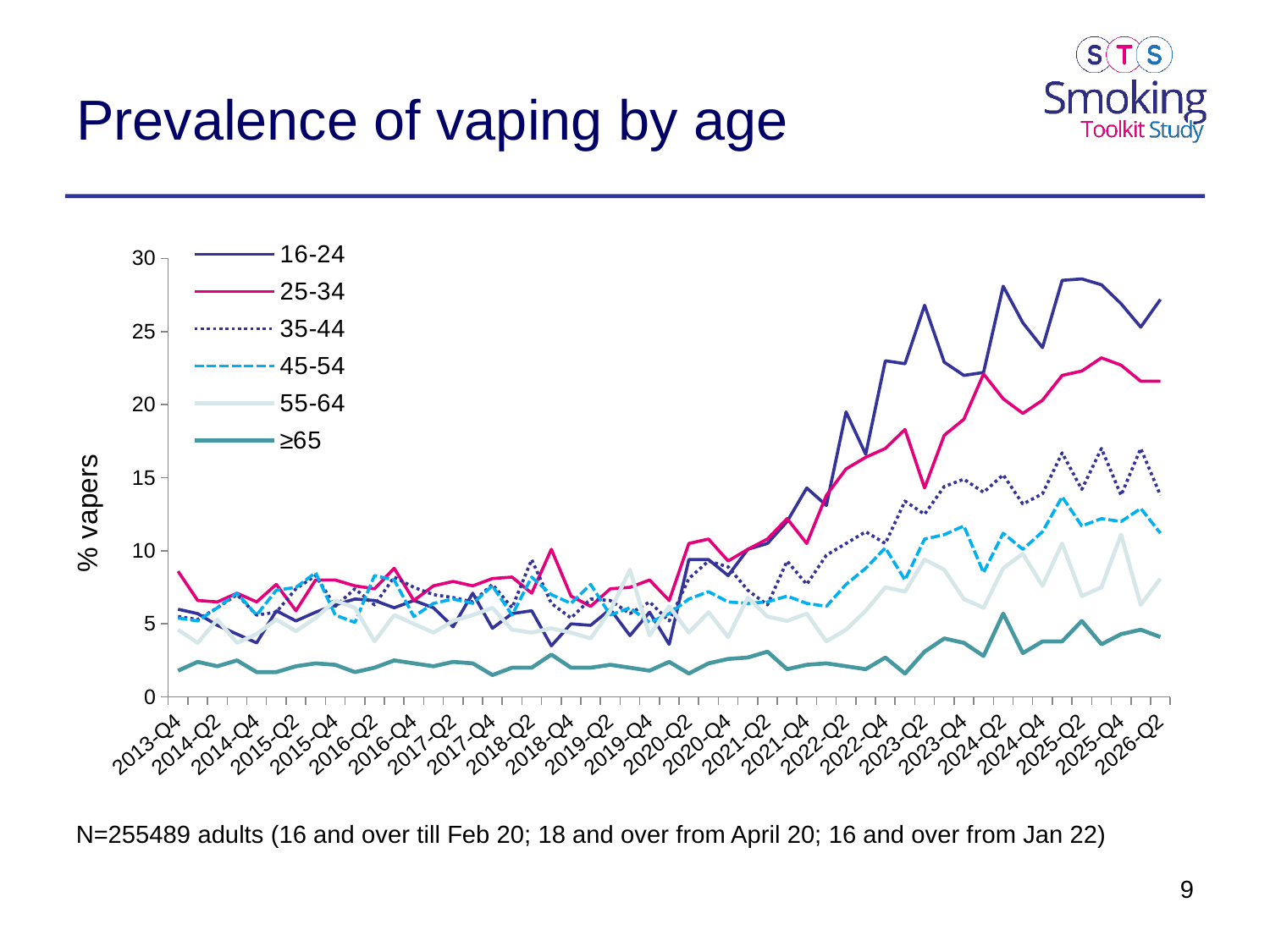
Which age group has the highest % vapers at 2026-Q2? 16-24 What is the label on the y axis? % vapers At 2026-Q2, which group has the higher % vapers, 35-44 or 45-54? 35-44 Is the value for the 16-24 group at 2026-Q2 greater or less than 25? greater What is the title of the chart? Prevalence of vaping by age Is the value for the ≥65 group at 2026-Q2 greater or less than 5? less Does the 16-24 line rise or fall between 2020-Q2 and 2025-Q2? rise Which age group has the lowest % vapers at 2026-Q2? ≥65 Is the value for the 25-34 group at 2026-Q2 greater or less than 20? greater How many age-group series does the legend list? 6 What kind of chart is shown on the slide? line chart